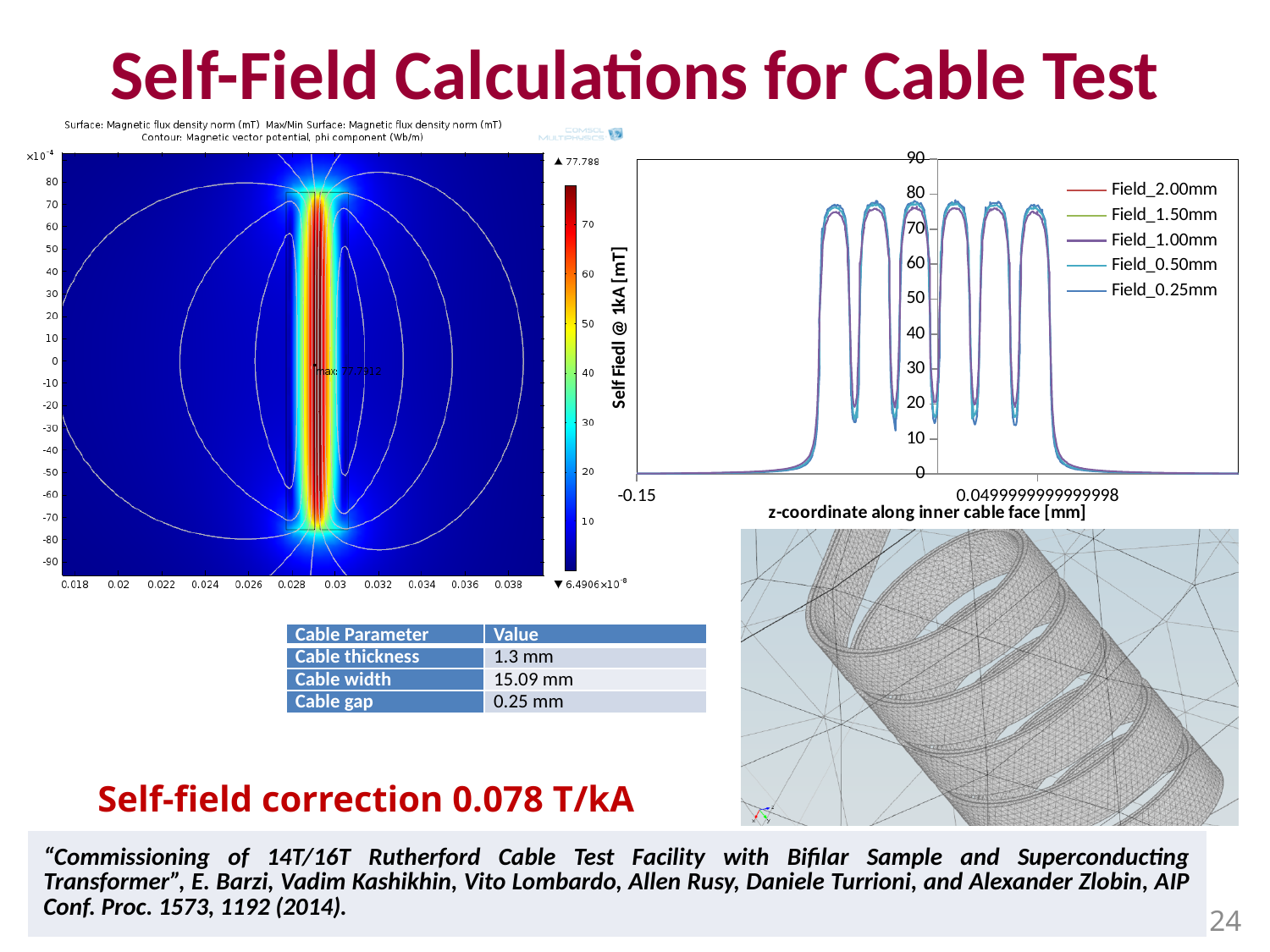
In the Self Field @ 1kA line chart, is the value in the dips between the peaks greater or less than 30? less In the Self Field @ 1kA line chart, is the peak value of the Field_2.00mm series greater or less than 70? greater In the Self Field @ 1kA line chart, how many peaks (plateaus) do the curves show across the x axis? 5 What type of chart is the plot of Self Field @ 1kA versus z-coordinate along inner cable face? line chart How many series does the legend of the Self Field @ 1kA line chart list? 5 In the Self Field @ 1kA line chart, what is the label of the x axis? z-coordinate along inner cable face [mm] In the Self Field @ 1kA line chart, what is the highest tick value shown on the y axis? 90 In the Self Field @ 1kA line chart, is the value of the curves at the far left of the x axis greater or less than 10? less In the COMSOL surface plot of magnetic flux density norm on the left, what maximum value is printed at the top of the colour bar? 77.788 In the Self Field @ 1kA line chart, what is the label of the y axis? Self Fiedl @ 1kA [mT]